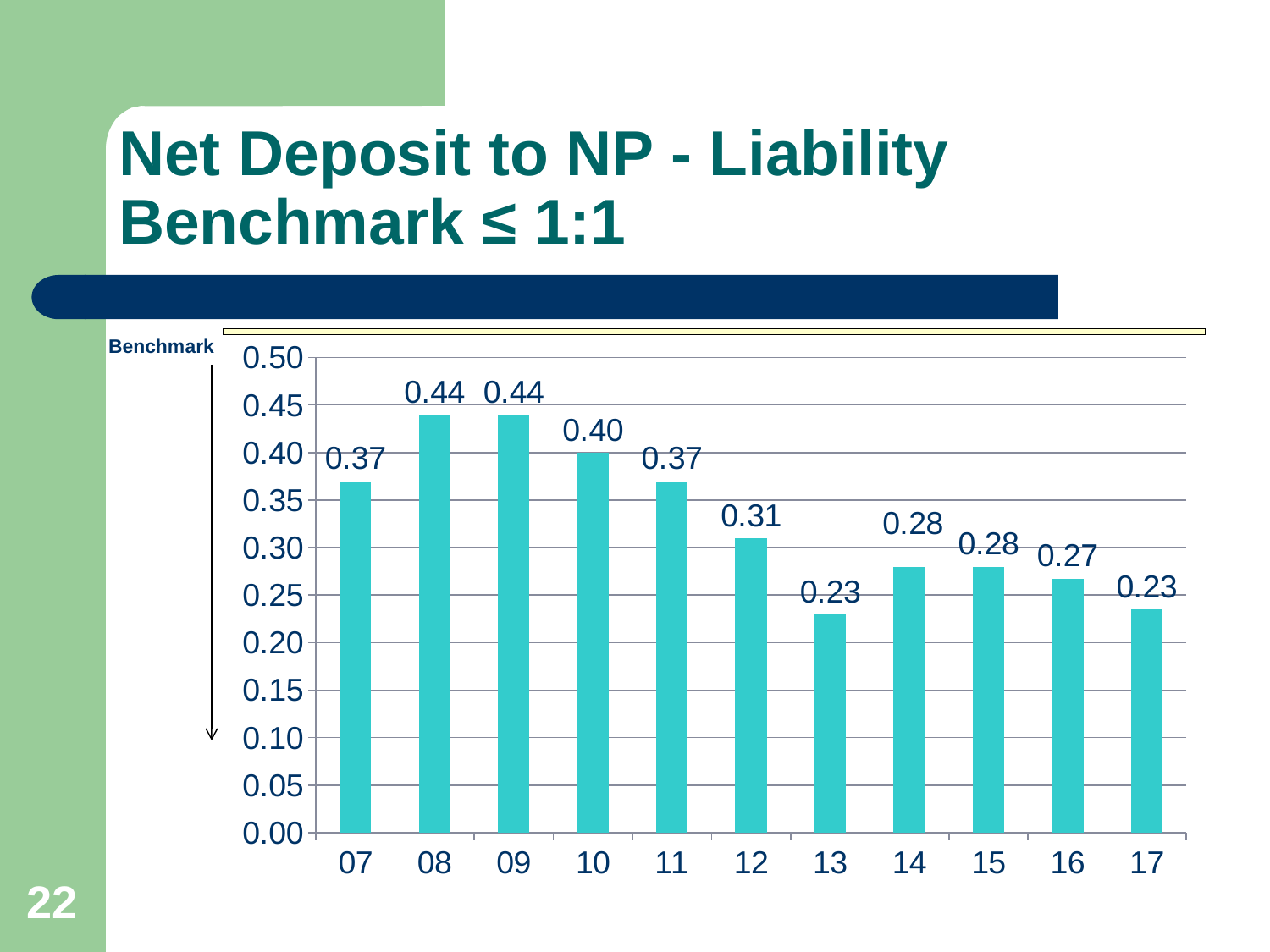
How many years are shown on the x axis? 11 What is the value for 16? 0.27 Which is larger, the value for 10 or the value for 14? 10 Which years have the highest value? 08 and 09 Do the values generally rise or fall from 09 to 17? fall What is the value for 12? 0.31 What is the difference between the values for 11 and 12? 0.06 What is the difference between the values for 08 and 17? 0.21 What is the value for 10? 0.40 What kind of chart is shown? bar chart Which years have the lowest value? 13 and 17 Is the value for 13 greater or less than 0.30? less